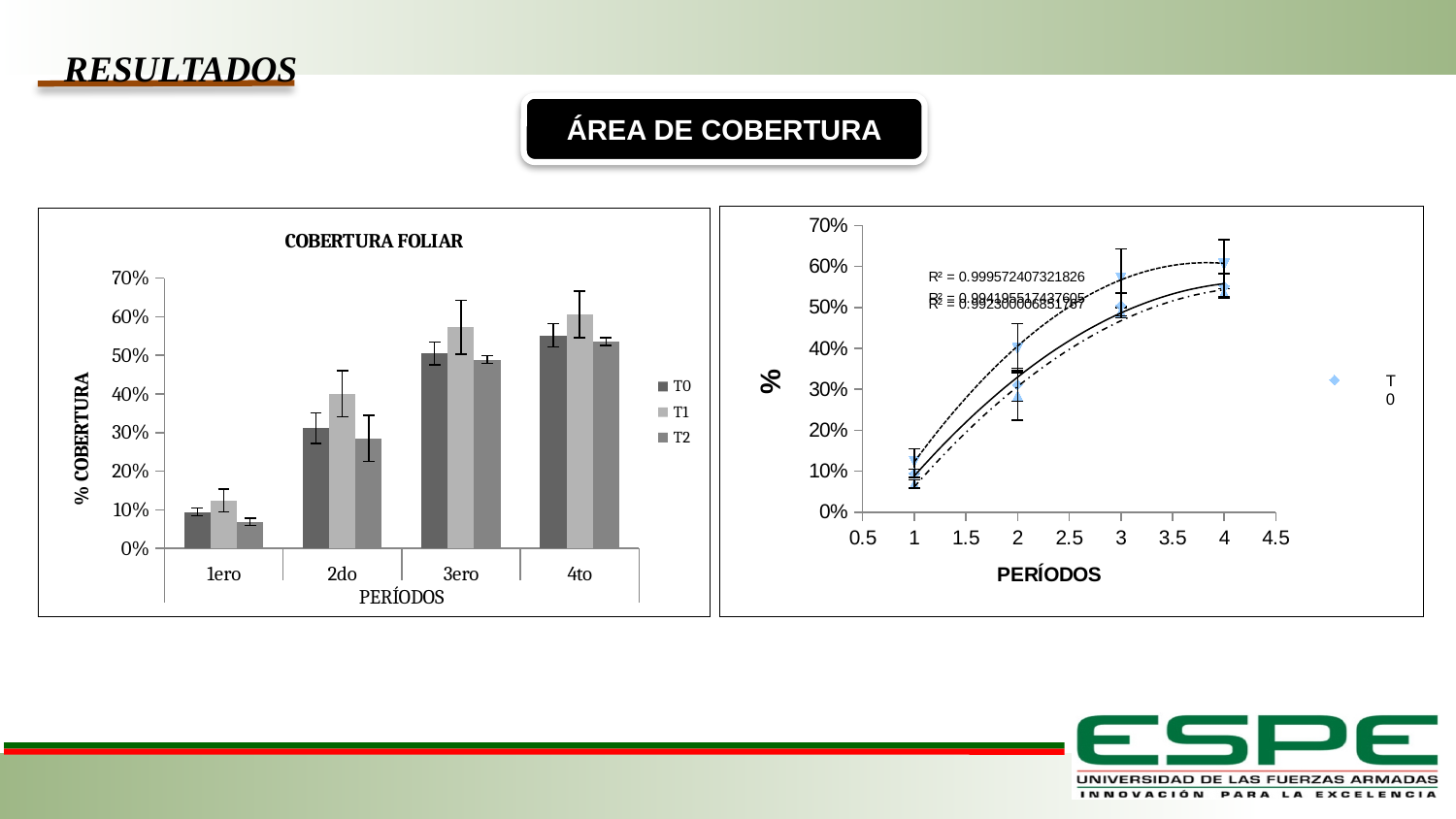
In the COBERTURA FOLIAR chart, is the value for T0 in the 1ero period greater or less than 20%? less In the COBERTURA FOLIAR chart, is the value for T1 in the 4to period greater or less than 50%? greater In the right chart, is the value at period 1 greater or less than 20%? less In the COBERTURA FOLIAR chart, do the coverage values generally rise or fall from 1ero to 4to? rise What type of chart is the left chart titled COBERTURA FOLIAR? bar chart In the COBERTURA FOLIAR chart, which is larger: T0 in the 1ero period or T0 in the 4to period? T0 in the 4to period What is the y-axis label of the COBERTURA FOLIAR chart? % COBERTURA In the COBERTURA FOLIAR chart, how many periods are shown on the x axis? 4 In the COBERTURA FOLIAR chart, how many series does the legend list? 3 In the COBERTURA FOLIAR chart, which period has the lowest coverage values for all three treatments? 1ero In the COBERTURA FOLIAR chart, which treatment has the highest bar in the 2do period? T1 What is the x-axis title of the right chart? PERÍODOS